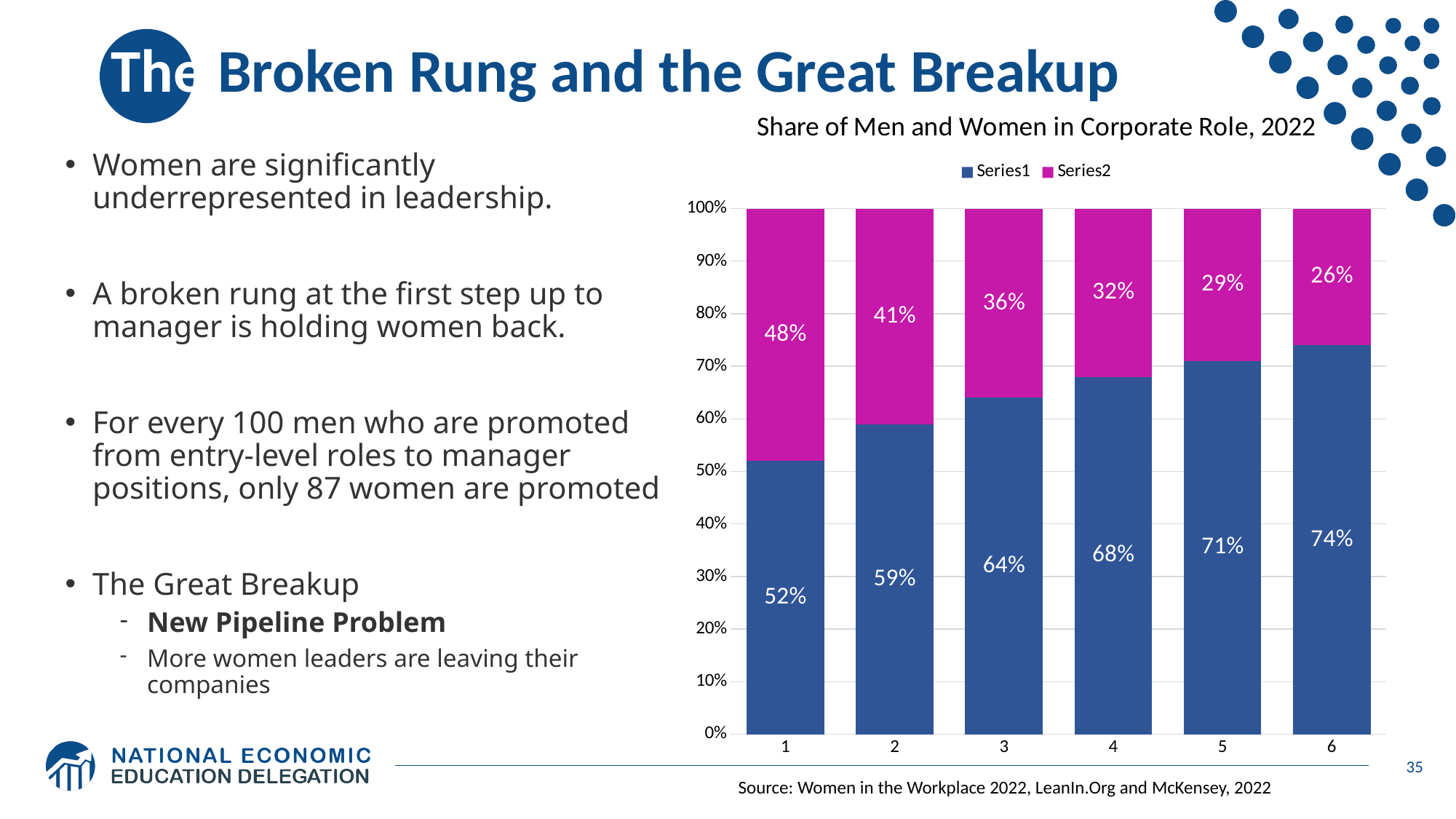
What kind of chart is shown on the slide? Stacked bar chart Which category has the lowest Series2 value? 6 Which category has the highest Series1 value? 6 How many categories are shown on the x axis? 6 What is the Series1 value for category 1? 52% How many series does the legend list? 2 What is the title of the chart? Share of Men and Women in Corporate Role, 2022 Which is larger: the Series2 value for category 2 or for category 5? Category 2 What is the Series1 value for category 6? 74% What is the Series2 value for category 4? 32% What is the difference between the Series1 values for category 6 and category 1? 22% Do the Series1 values rise or fall from category 1 to category 6? Rise